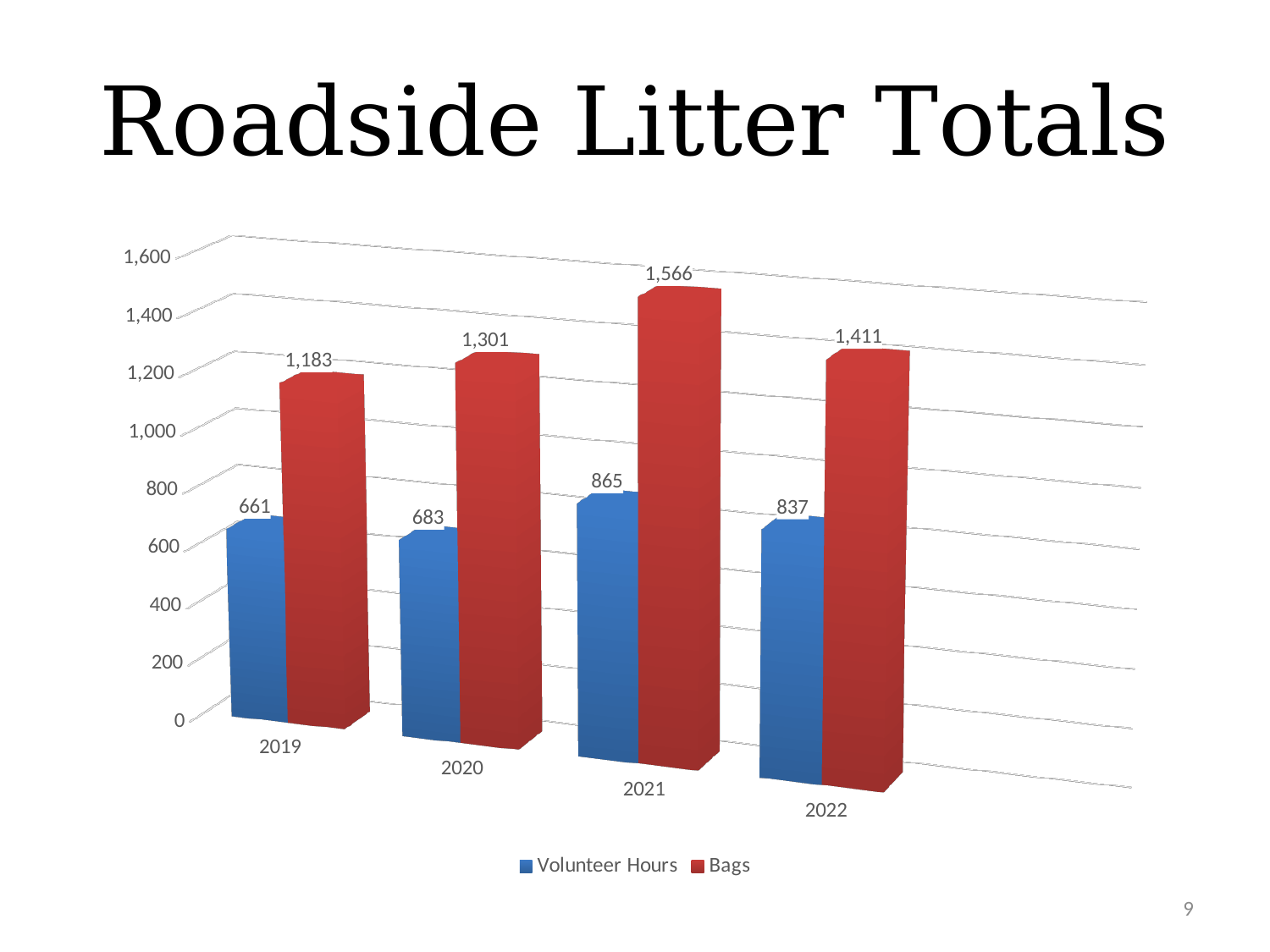
Which is larger: Volunteer Hours in 2021 or Volunteer Hours in 2022? Volunteer Hours in 2021 What kind of chart is shown on the slide? bar chart Do the Volunteer Hours values rise or fall from 2019 to 2021? rise What is the value for Bags in 2020? 1,301 What is the title of the slide containing the chart? Roadside Litter Totals How many series does the legend list? 2 What is the difference between Bags in 2021 and Bags in 2019? 383 What is the value for Volunteer Hours in 2019? 661 How many years are shown on the x axis? 4 What is the value for Bags in 2021? 1,566 Which year has the lowest value for Volunteer Hours? 2019 Which year has the highest value for Bags? 2021